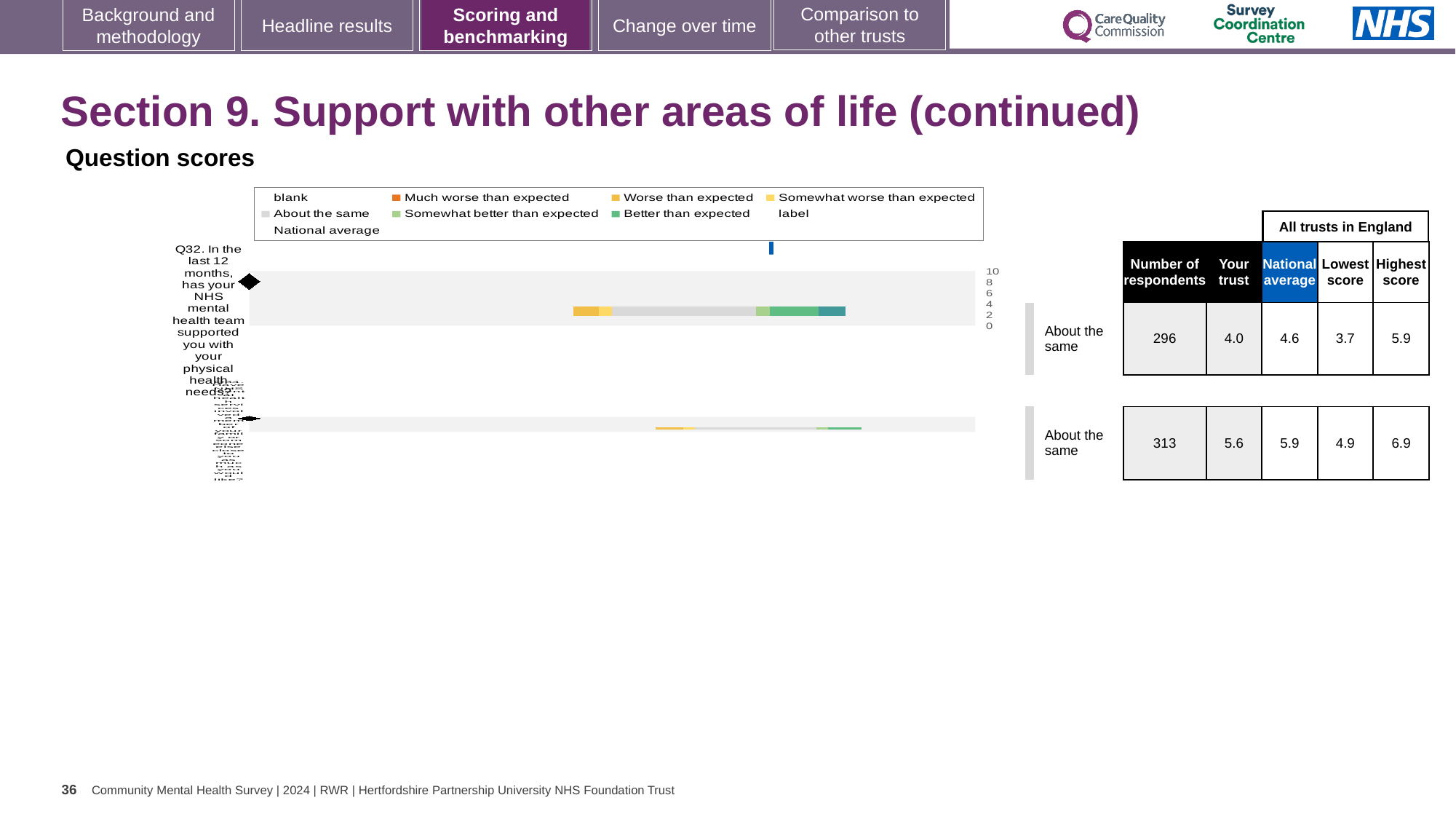
How many respondents answered Q32? 296 What kind of chart is shown on the slide? bar chart What is the difference between the national average and the trust's score for Q32? 0.6 What does the blue marker in the chart represent, according to the legend? National average What is the 'Your trust' score for Q32 (support with physical health needs)? 4.0 For Q32, which is larger: the trust's score or the national average? National average How many question bars are plotted in the chart? 2 For the second (lower) question row in the table, what is the 'Your trust' score? 5.6 What is the national average score for Q32? 4.6 What benchmark category is Q32 placed in? About the same What is the lowest score among all trusts in England for Q32? 3.7 What is the highest score among all trusts in England for Q32? 5.9